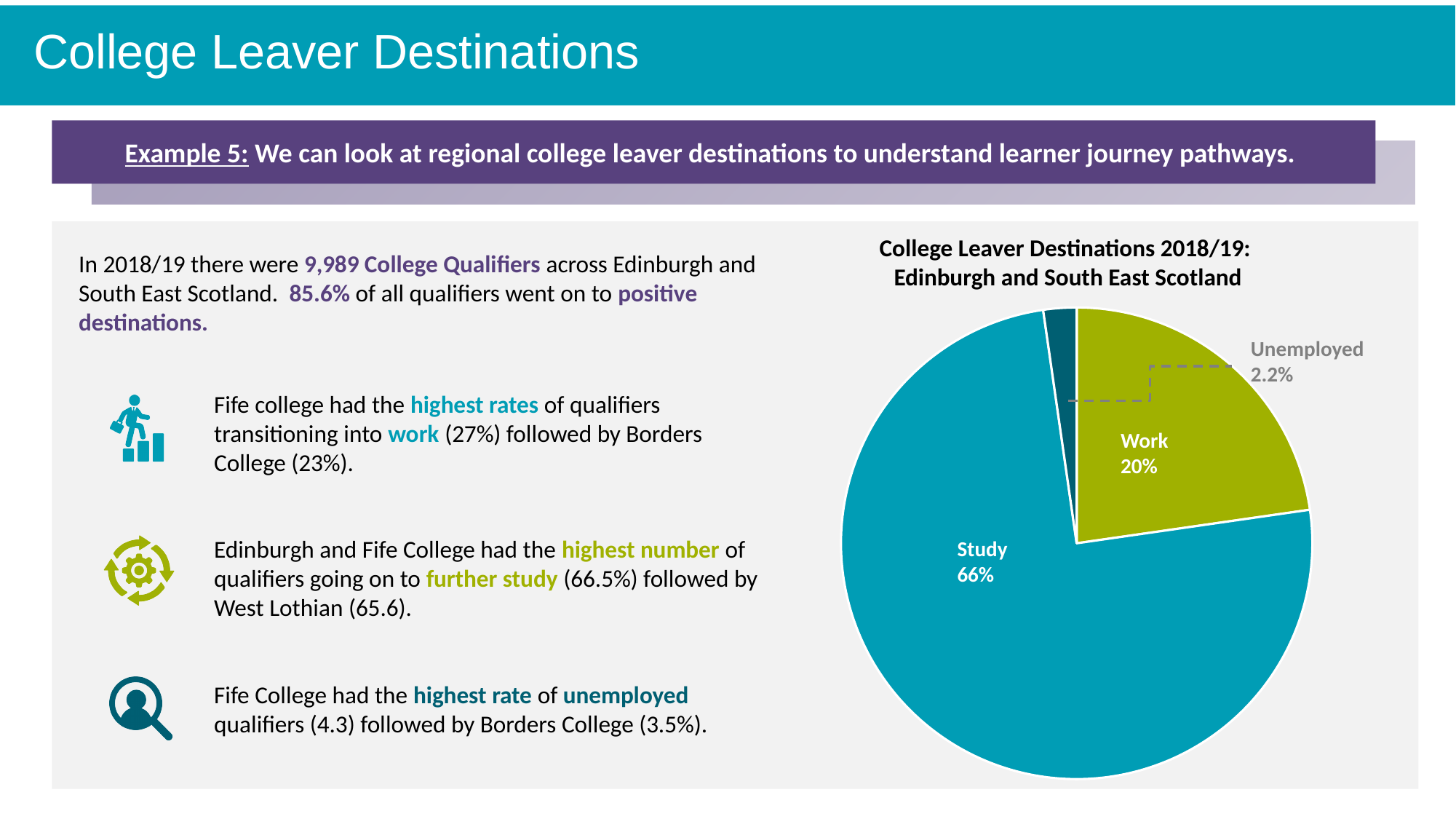
How many percentage points larger is the Work slice than the Unemployed slice? 17.8 What kind of chart is shown on the slide? pie chart What colour is the Work slice in the pie chart? green What is the title of the pie chart? College Leaver Destinations 2018/19: Edinburgh and South East Scotland What percentage of college leavers went into Work? 20% What percentage of college leavers went on to Study? 66% Which labelled destination has the smallest slice of the pie? Unemployed Which is larger, the Work slice or the Unemployed slice? Work Which destination has the largest slice of the pie? Study What share of the pie does the Study slice represent? 66% How many percentage points larger is the Study slice than the Work slice? 46 What percentage of college leavers were Unemployed? 2.2%